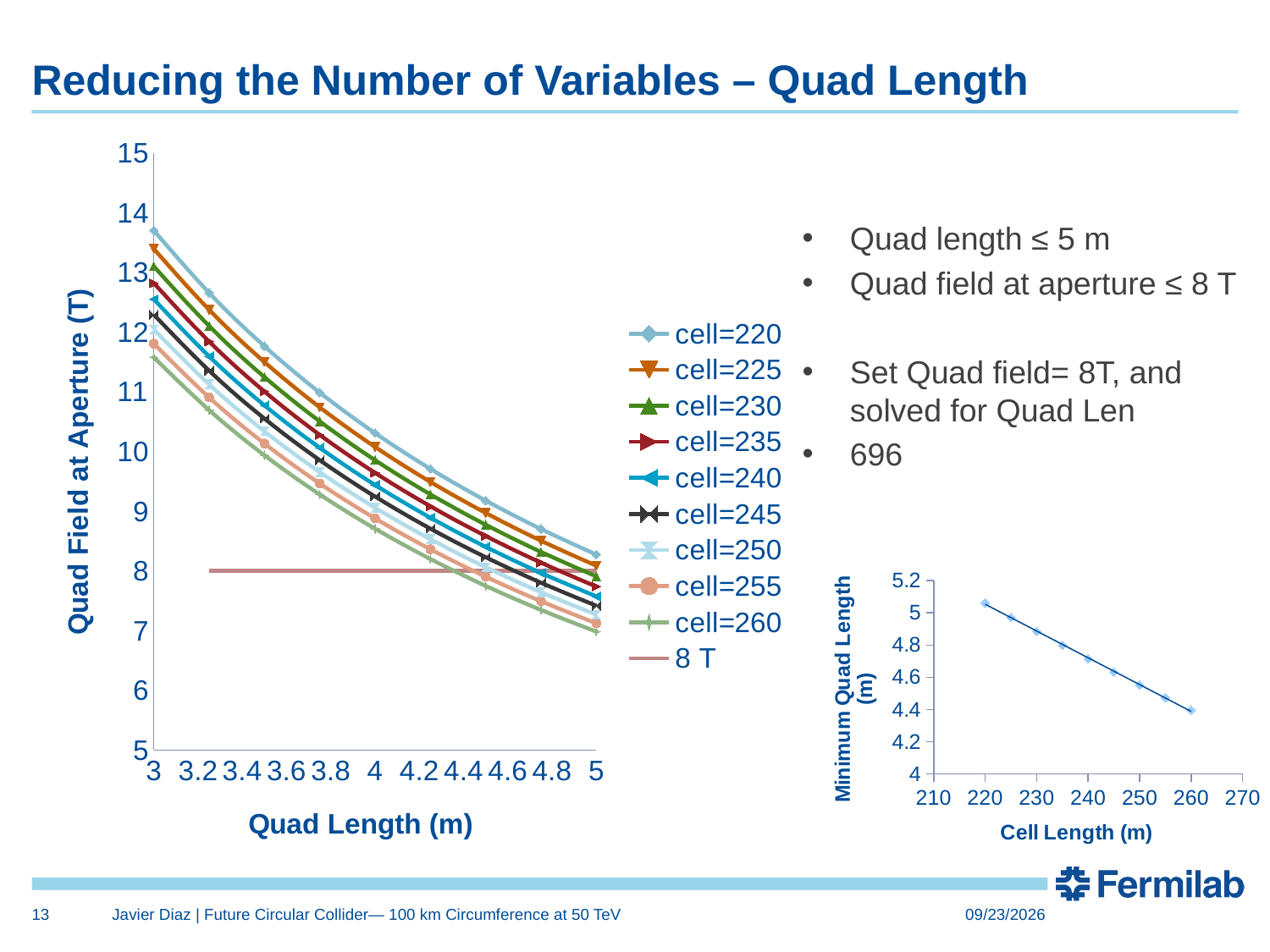
How many series does the legend of the left chart (Quad Field at Aperture vs Quad Length) list? 10 In the left chart (Quad Field at Aperture vs Quad Length), is the value for cell=260 at a Quad Length of 4.6 m greater or less than 8? less In the left chart (Quad Field at Aperture vs Quad Length), is the value for cell=220 at a Quad Length of 3.2 m greater or less than 12? greater In the left chart (Quad Field at Aperture vs Quad Length), what is the label of the x axis? Quad Length (m) What kind of chart is the right chart with Cell Length on the x axis? line chart In the left chart (Quad Field at Aperture vs Quad Length), which cell series has the lowest Quad Field at a Quad Length of 3 m? cell=260 In the right chart (Minimum Quad Length vs Cell Length), does Minimum Quad Length rise or fall as Cell Length increases? fall What kind of chart is the left chart with Quad Length on the x axis? line chart In the left chart (Quad Field at Aperture vs Quad Length), which cell series has the highest Quad Field at a Quad Length of 3 m? cell=220 In the right chart (Minimum Quad Length vs Cell Length), is the value at a Cell Length of 260 m greater or less than 4.6? less In the right chart (Minimum Quad Length vs Cell Length), which has the larger Minimum Quad Length: Cell Length 220 m or Cell Length 260 m? 220 m In the left chart (Quad Field at Aperture vs Quad Length), do the values of the cell series rise or fall as Quad Length increases? fall